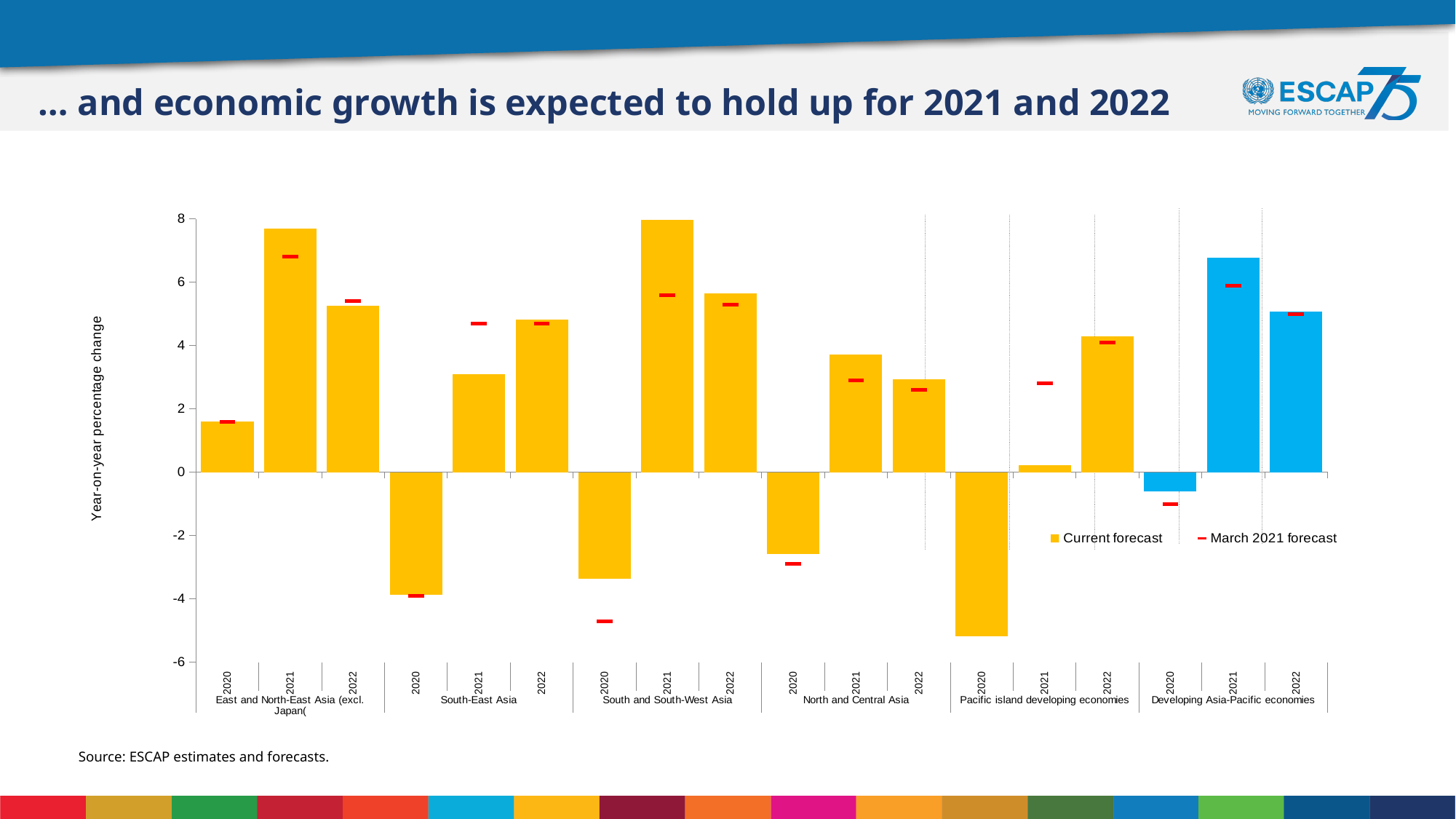
Is the current forecast for South-East Asia in 2020 greater or less than -2? less Which is larger, the 2022 current forecast for East and North-East Asia or for South-East Asia? East and North-East Asia Is the current forecast for Pacific island developing economies in 2020 greater or less than -4? less Do the current forecast bars for South-East Asia rise or fall from 2020 to 2022? rise Which subregion and year has the lowest current forecast bar? Pacific island developing economies, 2020 How many bars are plotted in the chart? 18 What kind of chart is shown on the slide? bar chart How many series does the legend list? 2 Is the current forecast for East and North-East Asia in 2021 greater or less than 6? greater What is the label on the vertical axis? Year-on-year percentage change Which subregion and year has the highest current forecast bar? South and South-West Asia, 2021 What are the two series named in the legend? Current forecast and March 2021 forecast